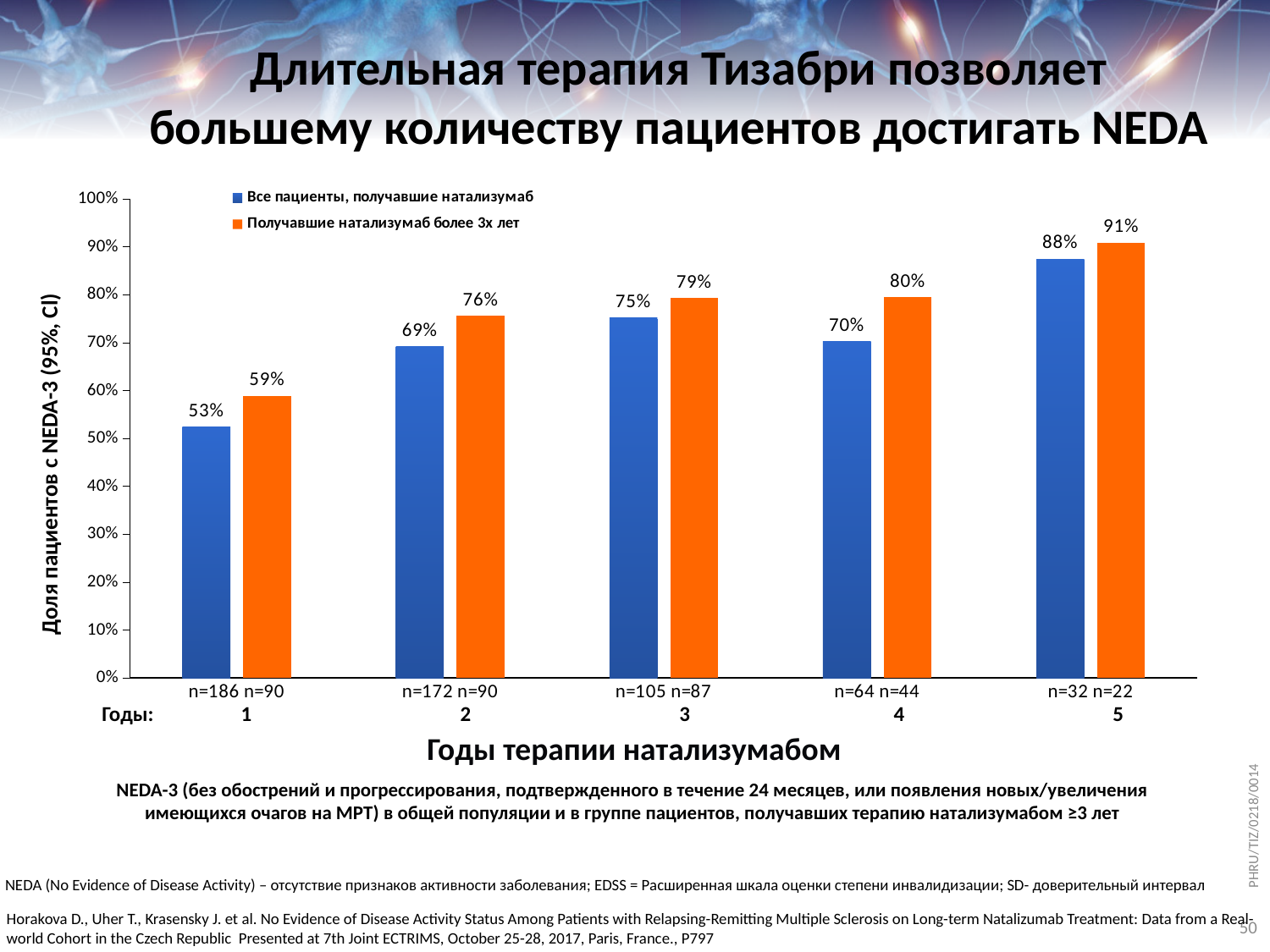
What colour are the bars for 'Получавшие натализумаб более 3х лет'? orange How many year categories are shown on the x axis? 5 What is the value for 'Все пациенты, получавшие натализумаб' in year 1? 53% In which year is the value for 'Все пациенты, получавшие натализумаб' lowest? 1 What is the difference between the two series in year 2? 7% What is the value for 'Все пациенты, получавшие натализумаб' in year 4? 70% Does the value for 'Получавшие натализумаб более 3х лет' rise or fall from year 1 to year 5? rise What is the value for 'Получавшие натализумаб более 3х лет' in year 5? 91% In which year is the value for 'Получавшие натализумаб более 3х лет' highest? 5 In year 3, which series has the larger value? Получавшие натализумаб более 3х лет What type of chart is shown on the slide? bar chart How many series does the legend list? 2